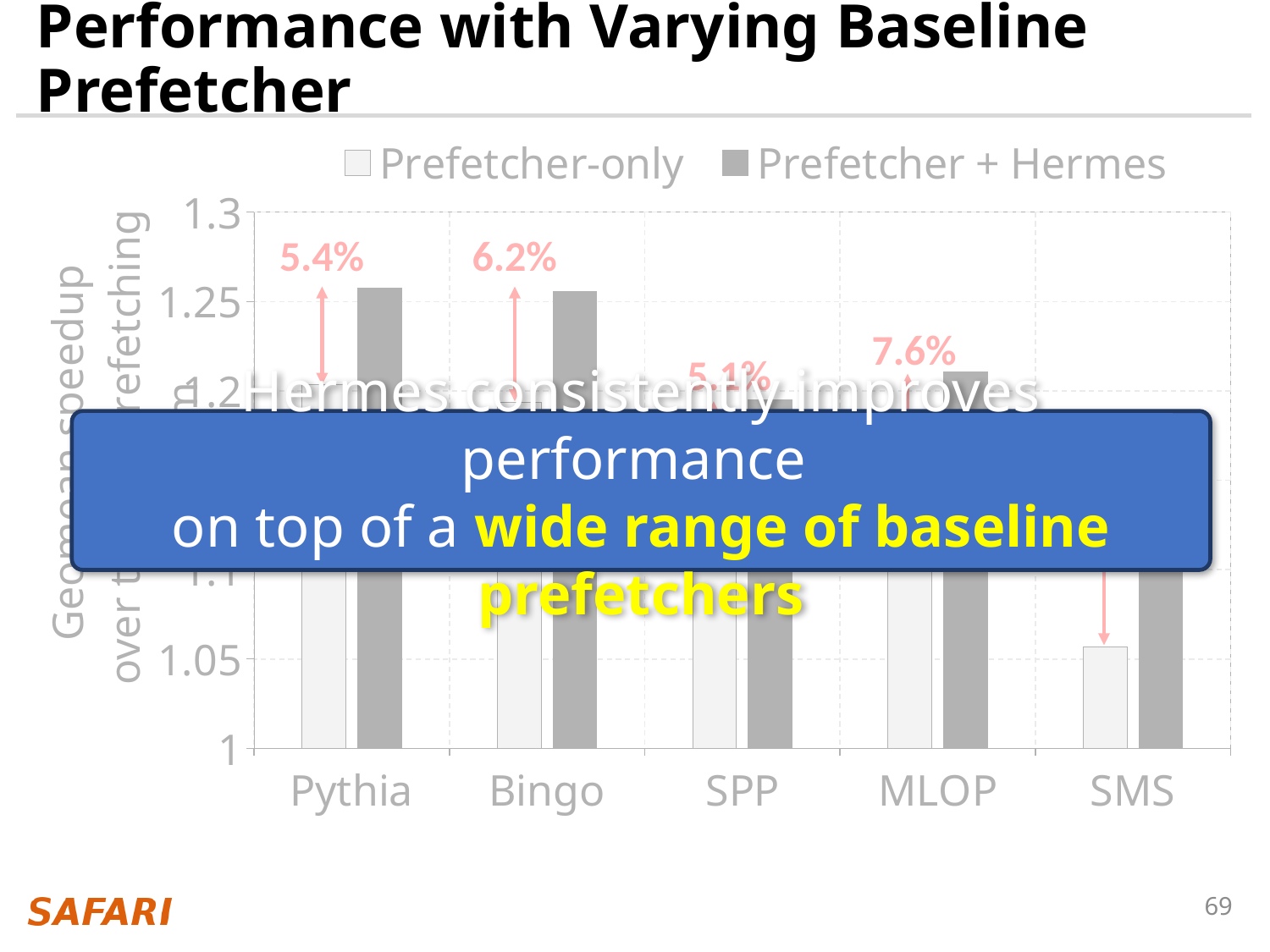
Is the Prefetcher-only value for SMS greater or less than 1.1? less What kind of chart is shown on the slide? bar chart How many baseline prefetchers are shown on the x axis? 5 Which baseline prefetcher has the lowest Prefetcher-only speedup? SMS How many series does the legend list? 2 What are the two series named in the legend? Prefetcher-only and Prefetcher + Hermes Is the Prefetcher + Hermes value for Pythia greater or less than 1.25? greater What is the title of the slide containing the chart? Performance with Varying Baseline Prefetcher What improvement percentage is annotated above the Pythia bars? 5.4% What improvement percentage is annotated above the SPP bars? 5.1% What improvement percentage is annotated above the Bingo bars? 6.2% What improvement percentage is annotated above the MLOP bars? 7.6%